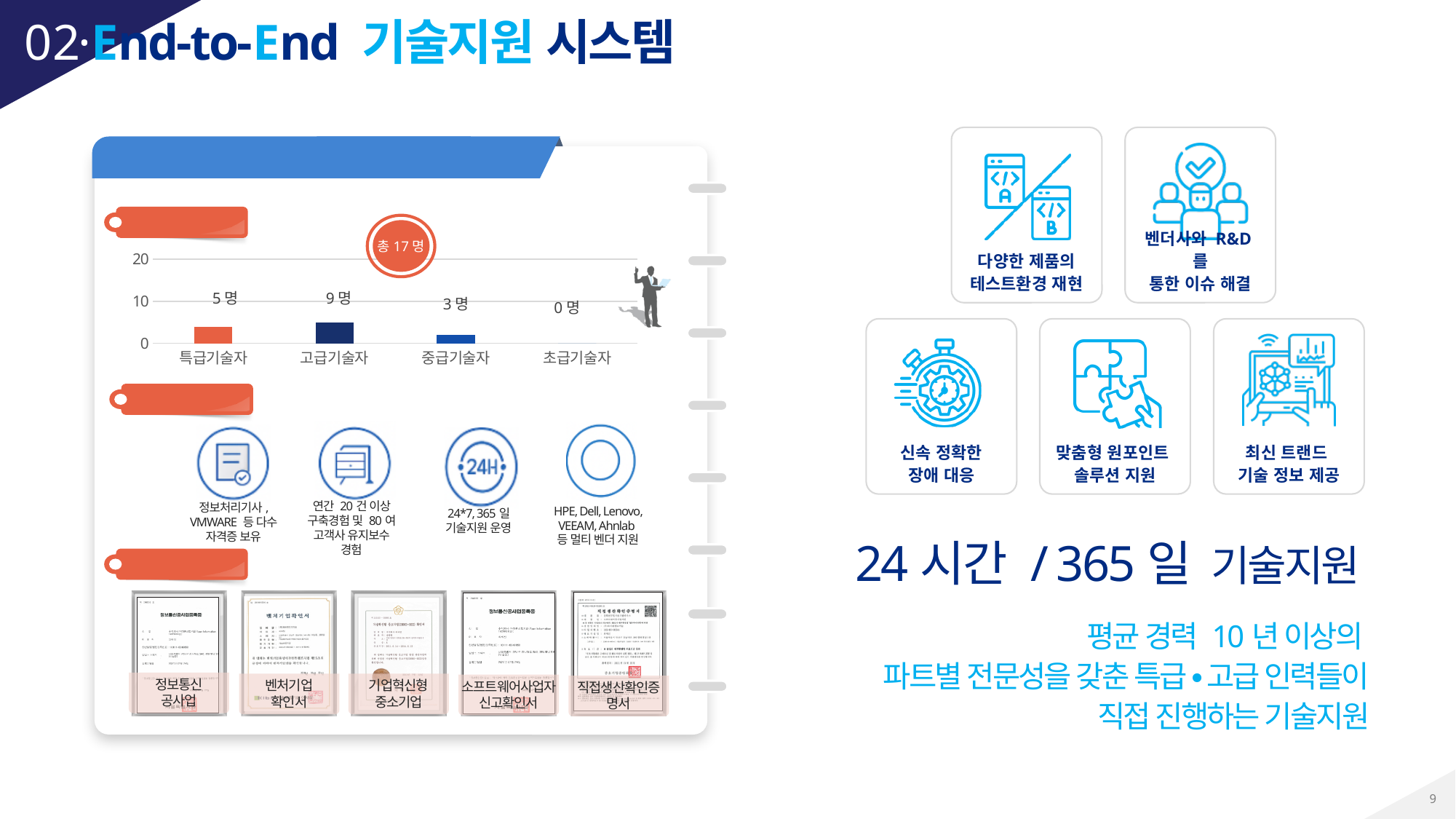
Which category has the highest value in the bar chart? 고급기술자 What kind of chart is shown on the slide? bar chart Which is larger, the value for 특급기술자 or the value for 중급기술자? 특급기술자 What is the difference between the values for 고급기술자 and 특급기술자? 4 명 What is the value for 특급기술자 in the bar chart? 5 명 Which category has the lowest value in the bar chart? 초급기술자 What is the value for 고급기술자 in the bar chart? 9 명 What total is shown in the circle above the bar chart? 총 17 명 Is the value for 고급기술자 greater or less than 10? less What is the value for 초급기술자 in the bar chart? 0 명 How many categories are shown on the x axis of the bar chart? 4 What is the value for 중급기술자 in the bar chart? 3 명